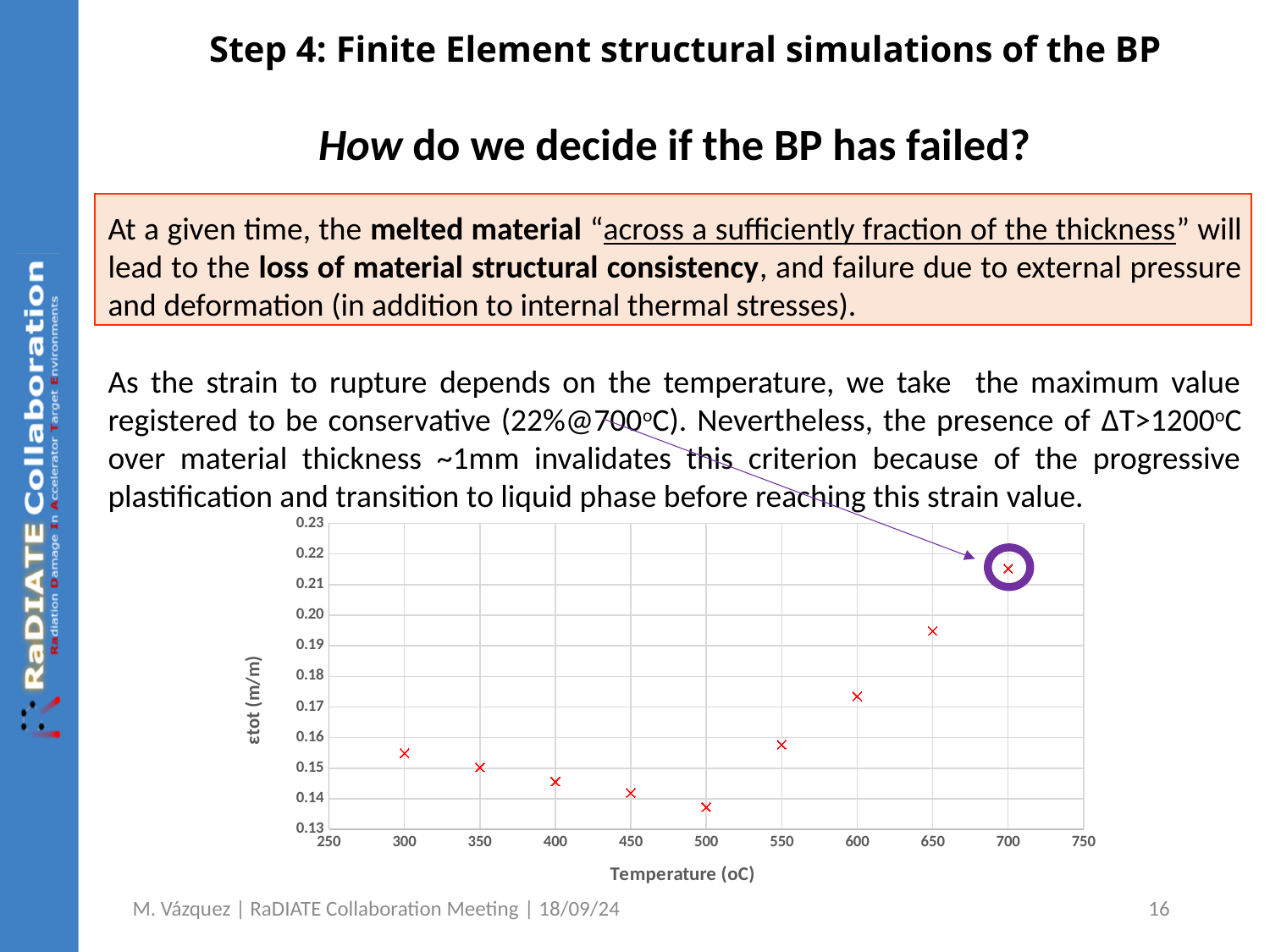
What kind of chart is shown on the slide? scatter plot Which has the larger strain value, the point at 300 or the point at 700? 700 Is the strain value at 650 greater or less than 0.19? greater At which temperature is the plotted strain value lowest? 500 What is the label of the x axis of the chart? Temperature (oC) Do the strain values rise or fall as temperature increases from 300 to 500? fall How many data points are plotted in the chart? 9 Is the strain value at 700 greater or less than 0.21? greater Is the strain value at 500 greater or less than 0.14? less Which has the larger strain value, the point at 500 or the point at 650? 650 At which temperature is the plotted strain value highest? 700